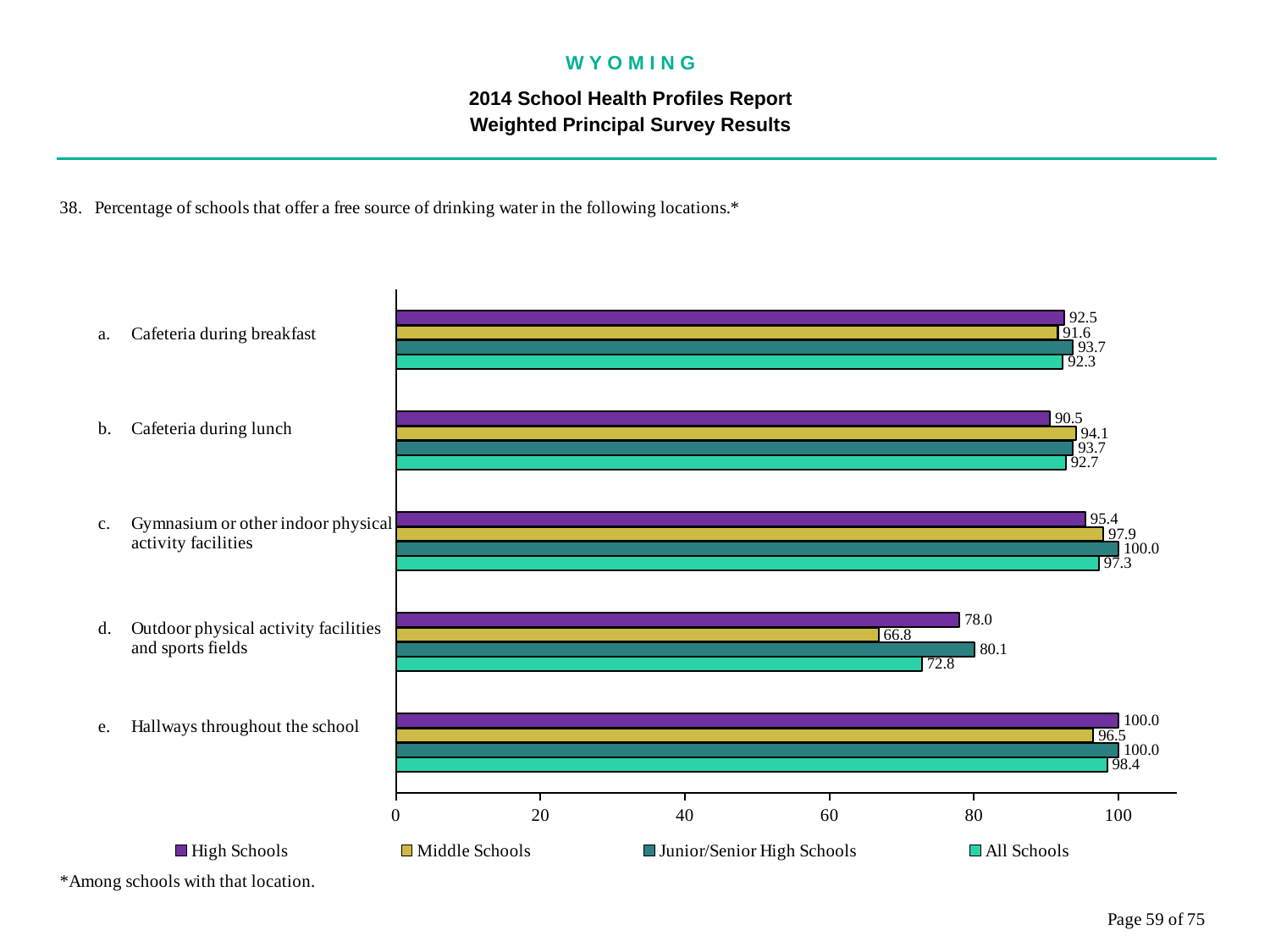
Is the All Schools value for 'Outdoor physical activity facilities and sports fields' greater or less than 80? less For 'Cafeteria during lunch', which is larger: the High Schools value or the Middle Schools value? Middle Schools How many series does the legend list? 4 How many locations (categories) are shown on the chart? 5 What is the difference between the Junior/Senior High Schools and Middle Schools values for 'Outdoor physical activity facilities and sports fields'? 13.3 What is the value for Junior/Senior High Schools for 'Gymnasium or other indoor physical activity facilities'? 100.0 What is the value for All Schools for 'Cafeteria during lunch'? 92.7 Which location has the lowest value for All Schools? Outdoor physical activity facilities and sports fields What kind of chart is shown on the slide? bar chart Which series is shown in purple in the legend? High Schools Which location has the highest value for High Schools? Hallways throughout the school What is the value for Middle Schools for 'Outdoor physical activity facilities and sports fields'? 66.8